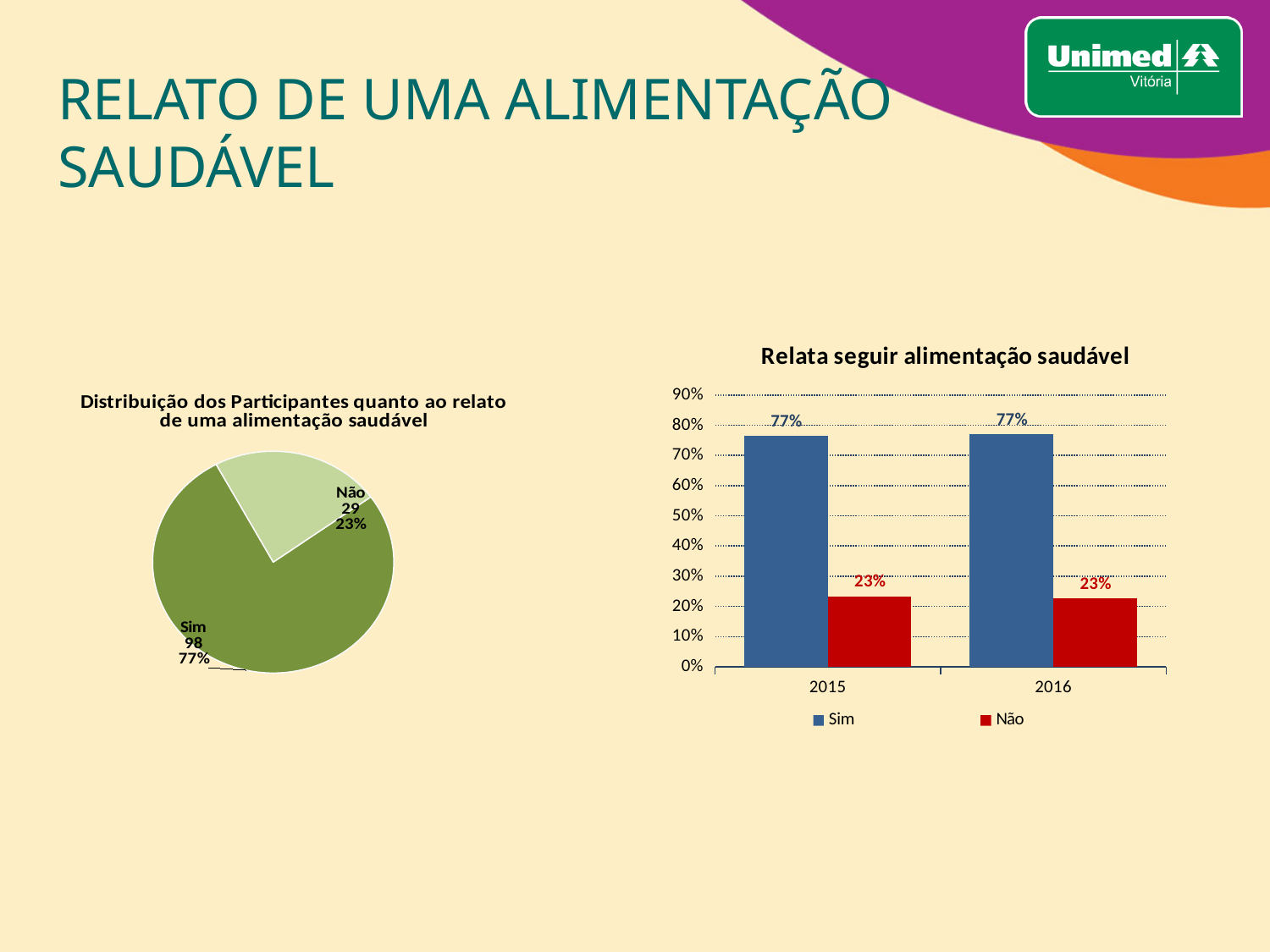
In the pie chart 'Distribuição dos Participantes quanto ao relato de uma alimentação saudável', what is the difference between the number of 'Sim' and 'Não' participants? 69 In the bar chart 'Relata seguir alimentação saudável', what is the difference between 'Sim' and 'Não' in 2015? 54% In the pie chart 'Distribuição dos Participantes quanto ao relato de uma alimentação saudável', how many slices are there? 2 In the bar chart 'Relata seguir alimentação saudável', what is the value for 'Não' in 2016? 23% In the bar chart 'Relata seguir alimentação saudável', what is the value for 'Sim' in 2015? 77% In the pie chart 'Distribuição dos Participantes quanto ao relato de uma alimentação saudável', how many participants answered 'Sim'? 98 In the bar chart 'Relata seguir alimentação saudável', how many series does the legend list? 2 In the bar chart 'Relata seguir alimentação saudável', which is larger in 2016, 'Sim' or 'Não'? Sim What kind of chart is the chart titled 'Relata seguir alimentação saudável'? Bar chart In the pie chart 'Distribuição dos Participantes quanto ao relato de uma alimentação saudável', how many participants answered 'Não'? 29 In the pie chart 'Distribuição dos Participantes quanto ao relato de uma alimentação saudável', which slice is the largest? Sim In the pie chart 'Distribuição dos Participantes quanto ao relato de uma alimentação saudável', what share of the pie does the 'Não' slice represent? 23%